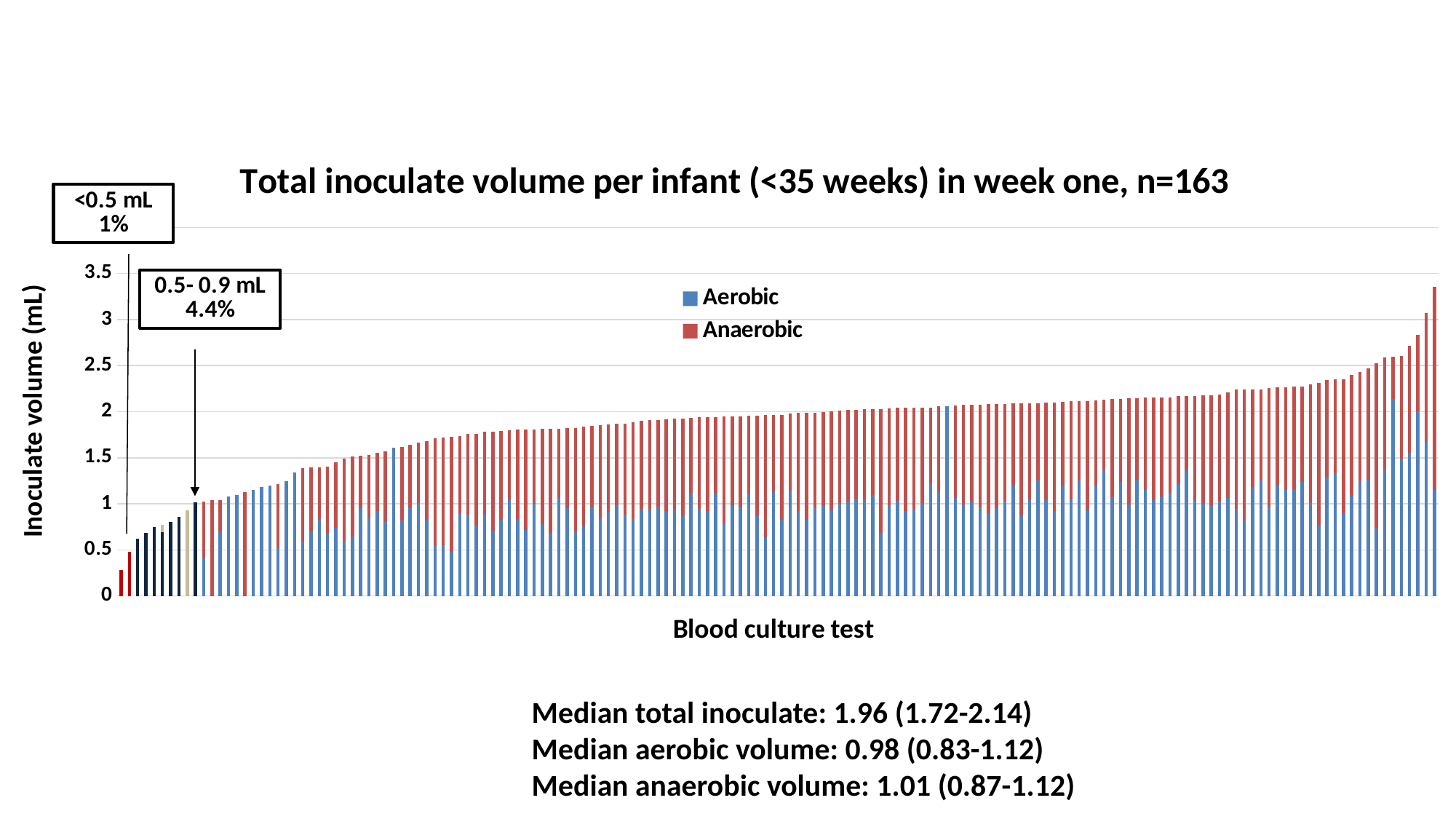
What kind of chart is shown on the slide? Stacked bar chart What percentage of tests had a total inoculate volume of 0.5-0.9 mL, according to the annotation? 4.4% Is the total inoculate volume of the leftmost bar greater or less than 0.5 mL? less What are the two series named in the legend? Aerobic and Anaerobic Is the total inoculate volume of the tallest (rightmost) bar greater or less than 3 mL? greater What is the title of the chart? Total inoculate volume per infant (<35 weeks) in week one, n=163 How many blood culture tests (bars) does the chart represent, according to the title? 163 Do the total bar heights rise or fall from left to right along the x axis? Rise What is the median total inoculate volume stated below the chart? 1.96 (1.72-2.14) How many series does the legend list? 2 What percentage of tests had a total inoculate volume below 0.5 mL, according to the annotation? 1% Which median is larger, the median aerobic volume or the median anaerobic volume? Median anaerobic volume